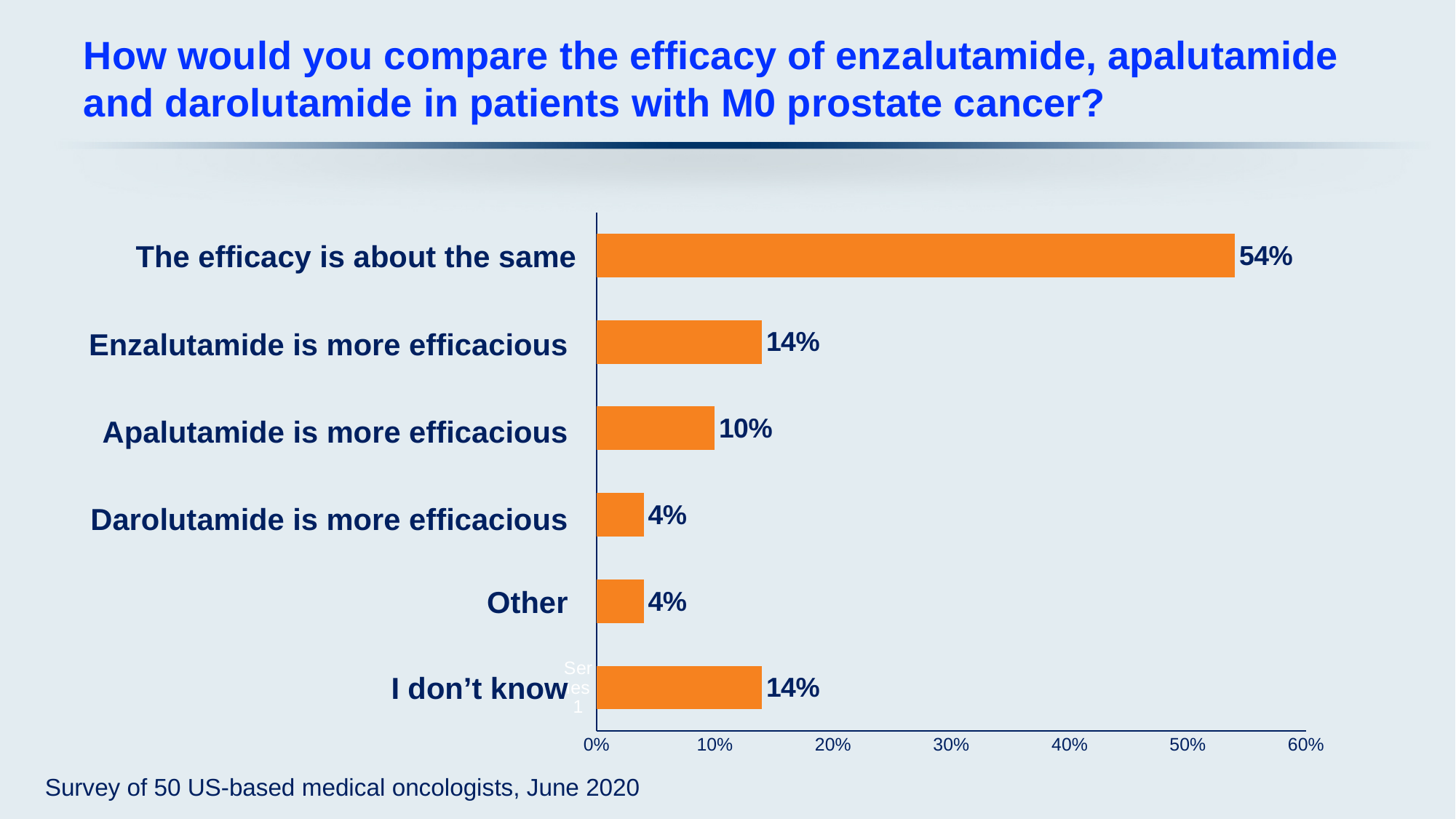
Which response option has the highest percentage? The efficacy is about the same Is the value for 'The efficacy is about the same' greater or less than 50%? greater What percentage of respondents said enzalutamide is more efficacious? 14% What percentage of respondents said apalutamide is more efficacious? 10% Which has a larger value: 'Enzalutamide is more efficacious' or 'Apalutamide is more efficacious'? Enzalutamide is more efficacious How many response categories are shown in the chart? 6 What percentage of respondents answered 'I don't know'? 14% What percentage of respondents said darolutamide is more efficacious? 4% What is the difference in percentage points between 'The efficacy is about the same' and 'Enzalutamide is more efficacious'? 40 percentage points What percentage of respondents said the efficacy is about the same? 54% What is the difference in percentage points between 'Apalutamide is more efficacious' and 'Darolutamide is more efficacious'? 6 percentage points What type of chart is shown on the slide? Bar chart